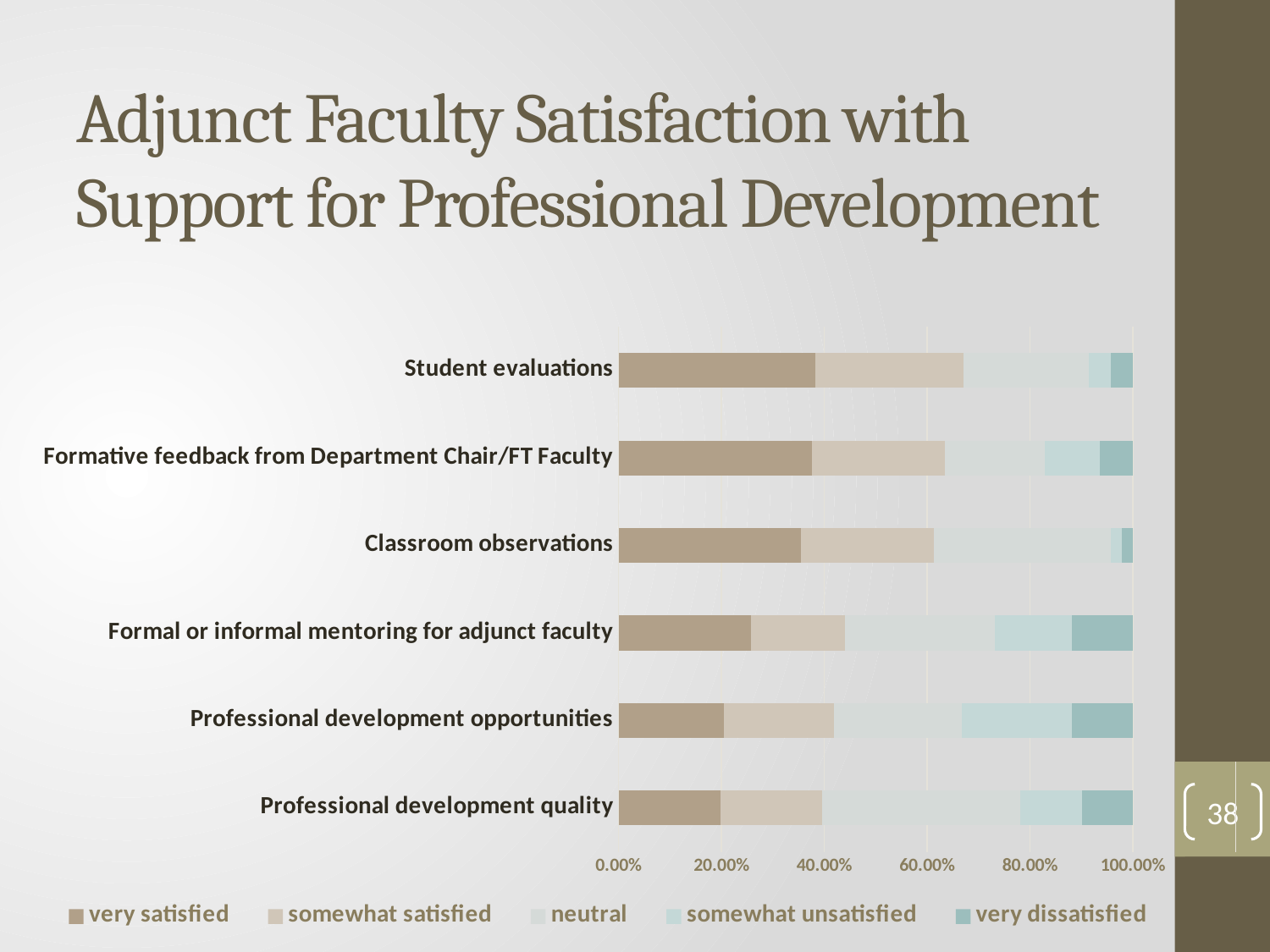
Is the 'very satisfied' value for Student evaluations greater or less than 20.00%? greater Is the 'very satisfied' value for Classroom observations greater or less than 20.00%? greater Is the 'very satisfied' segment larger for Student evaluations or for Formal or informal mentoring for adjunct faculty? Student evaluations Is the 'very satisfied' value for Formal or informal mentoring for adjunct faculty greater or less than 40.00%? less How many categories (support types) are plotted on the chart? 6 How many series does the legend list? 5 What is the title of the slide containing the chart? Adjunct Faculty Satisfaction with Support for Professional Development Which category has the smallest 'very dissatisfied' segment? Classroom observations Which series is listed first in the legend? very satisfied Is the 'very dissatisfied' segment larger for Formal or informal mentoring for adjunct faculty or for Classroom observations? Formal or informal mentoring for adjunct faculty What kind of chart is shown on the slide? stacked bar chart